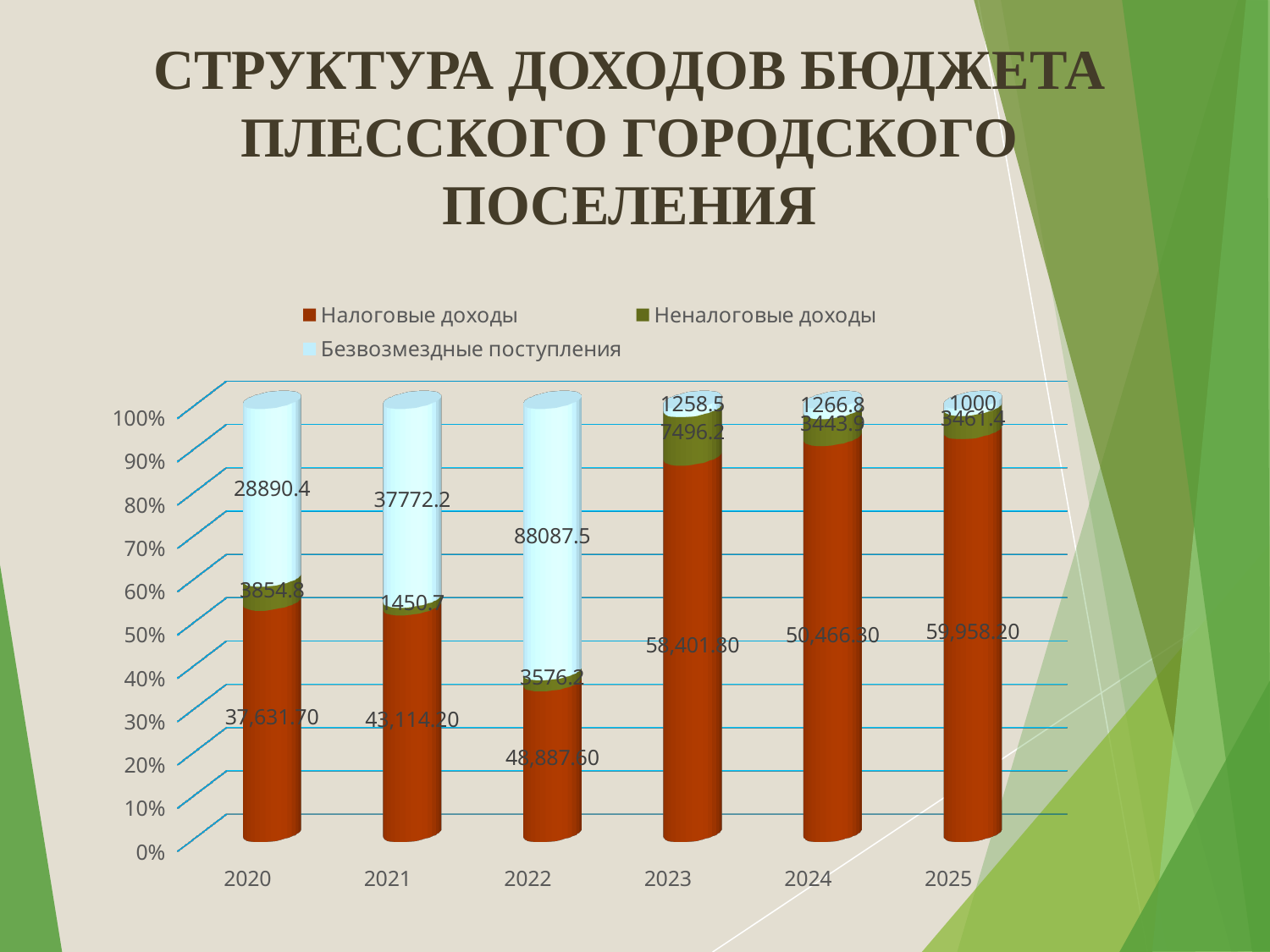
What is the difference between the Налоговые доходы values for 2025 and 2024? 9,491.90 How many years are shown on the x axis? 6 What is the value of Неналоговые доходы for 2023? 7496.2 In which year is the value of Безвозмездные поступления the highest? 2022 How many series does the legend list? 3 What is the value of Безвозмездные поступления for 2025? 1000 Which year has the larger value of Налоговые доходы, 2023 or 2024? 2023 What is the value of Налоговые доходы for 2020? 37,631.70 What is the value of Безвозмездные поступления for 2022? 88087.5 In which year is the value of Налоговые доходы the highest? 2025 What kind of chart is shown on the slide? Stacked bar chart In which year is the value of Налоговые доходы the lowest? 2020